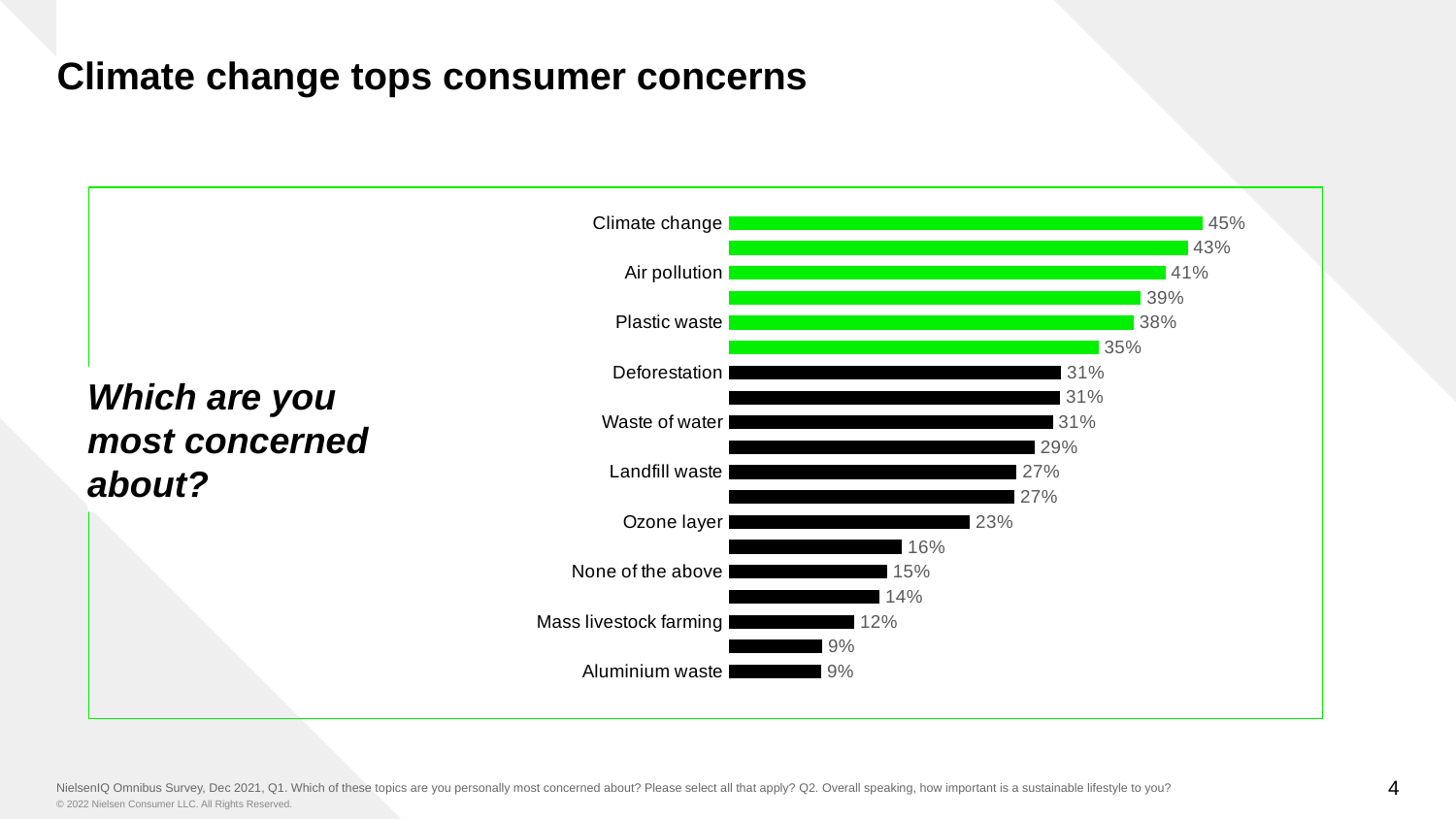
What is the value shown for Plastic waste? 38% What is the value shown for Ozone layer? 23% What is the difference between the values for Plastic waste and Landfill waste? 11 percentage points Which concern has the highest value in the chart? Climate change What kind of chart is shown on the slide? Bar chart What is the value shown for Mass livestock farming? 12% What is the lowest value shown in the chart? 9% What question is the chart answering, as written to the left of the bars? Which are you most concerned about? Which has a larger value, Landfill waste or Ozone layer? Landfill waste What is the difference between the values for Climate change and Air pollution? 4 percentage points What percentage of consumers are concerned about climate change? 45% What is the value shown for Air pollution? 41%